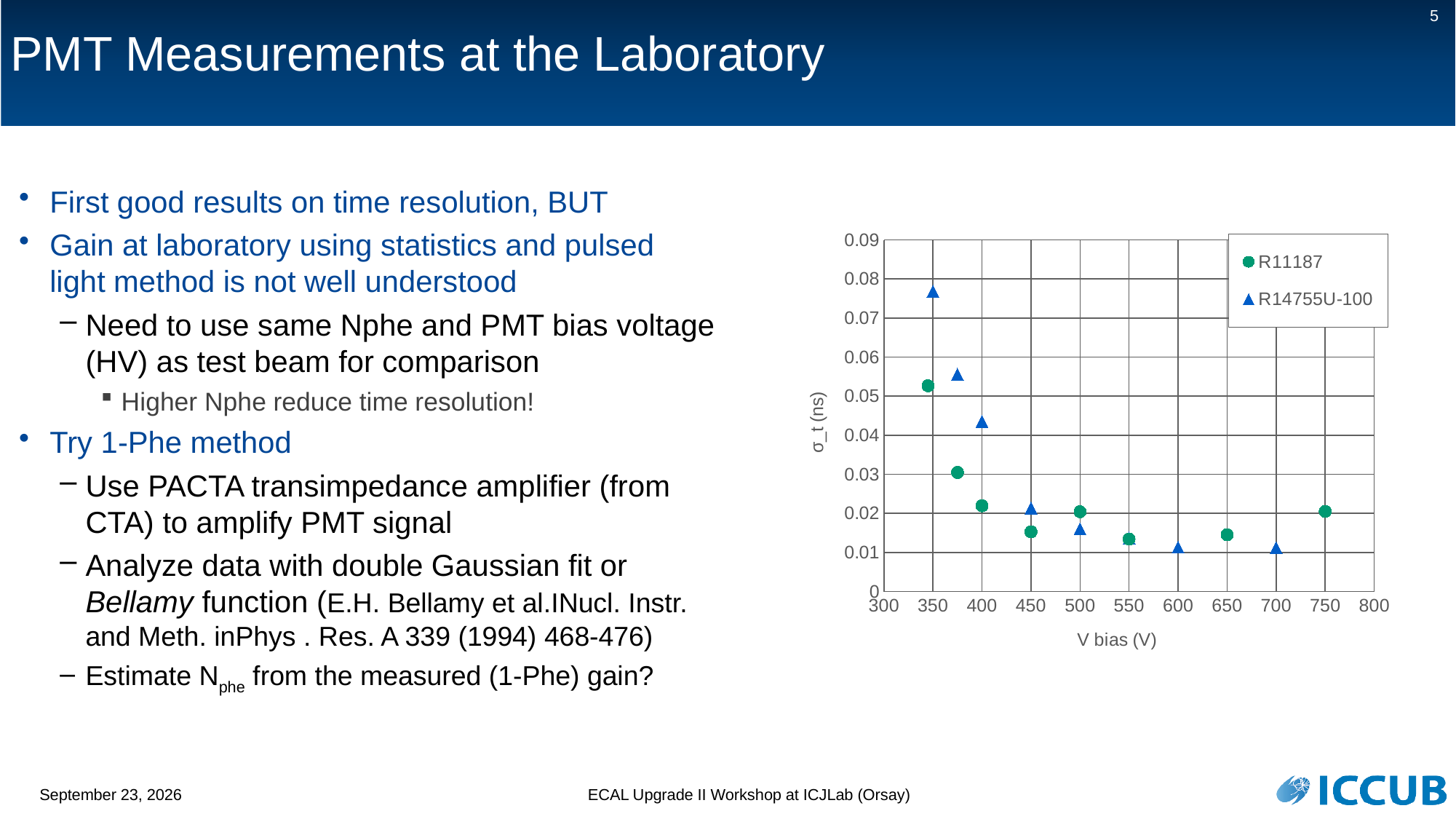
Is the R14755U-100 value at 700 V greater or less than 0.02? less Which series has the highest plotted σ_t value on the chart? R14755U-100 Is the R14755U-100 value at 400 V greater or less than 0.04? greater How many series does the chart legend list? 2 At 350 V, which series has the larger σ_t value, R11187 or R14755U-100? R14755U-100 What are the two series named in the chart legend? R11187 and R14755U-100 Is the R11187 value at 350 V greater or less than 0.06? less Between 350 V and 450 V, do the R14755U-100 values rise or fall as V bias increases? fall What kind of chart is shown on the slide? scatter chart What is the label of the x axis of the chart? V bias (V)